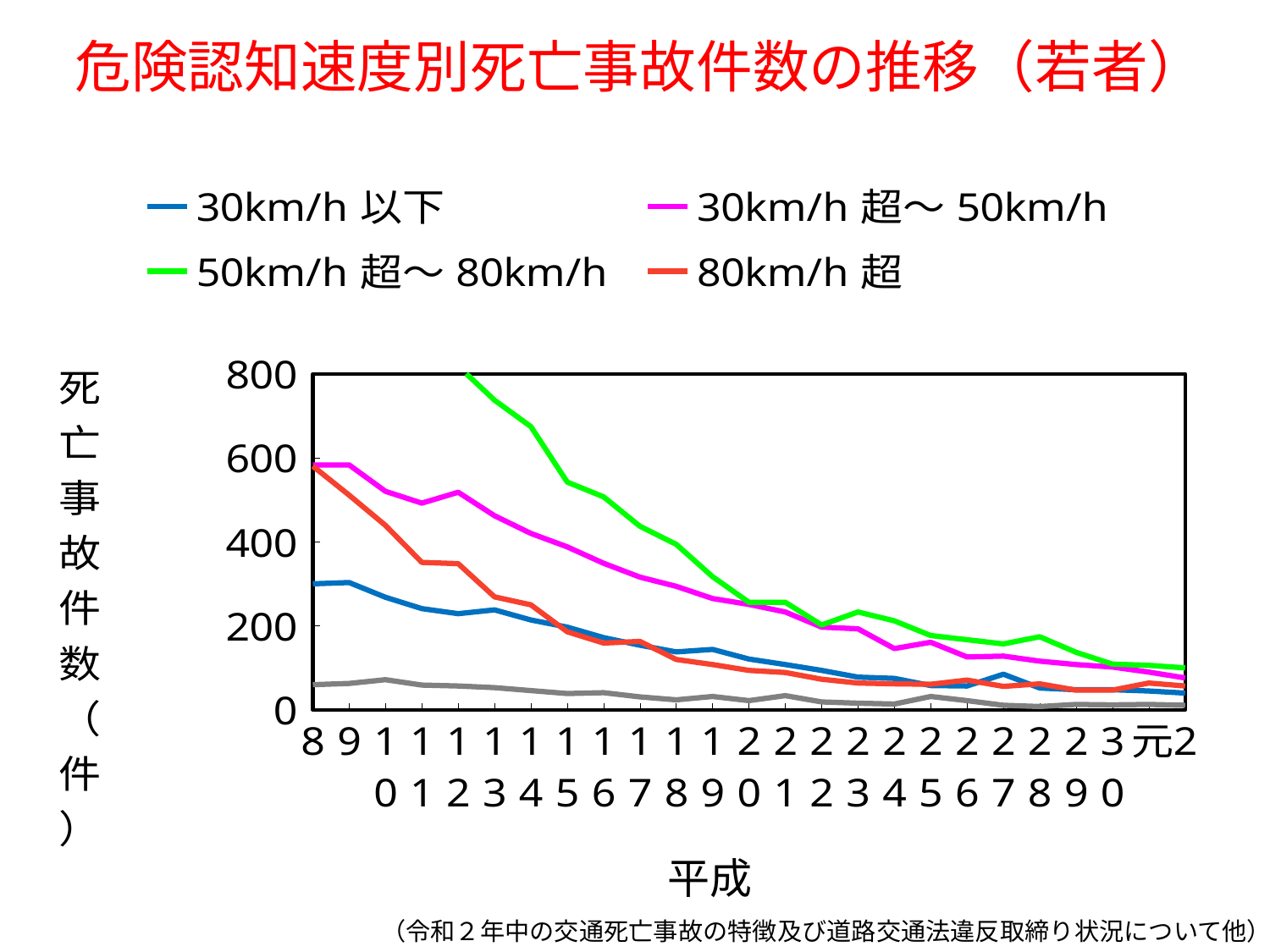
Is the value for 30km/h 超〜 50km/h in 平成8 greater or less than 400? greater Is the value for 50km/h 超〜 80km/h in 平成15 greater or less than 400? greater In 平成8, which is larger: 30km/h 超〜 50km/h or 30km/h 以下? 30km/h 超〜 50km/h Is the value for 30km/h 以下 in 令和2 greater or less than 100? less What kind of chart is shown on the slide? line chart Overall, do the values for 30km/h 超〜 50km/h rise or fall from 平成8 to 令和2? fall How many series does the legend list? 4 What is the title of the chart? 危険認知速度別死亡事故件数の推移（若者） What is the label of the vertical axis? 死亡事故件数（件） In 平成20, which is larger: 50km/h 超〜 80km/h or 80km/h 超? 50km/h 超〜 80km/h